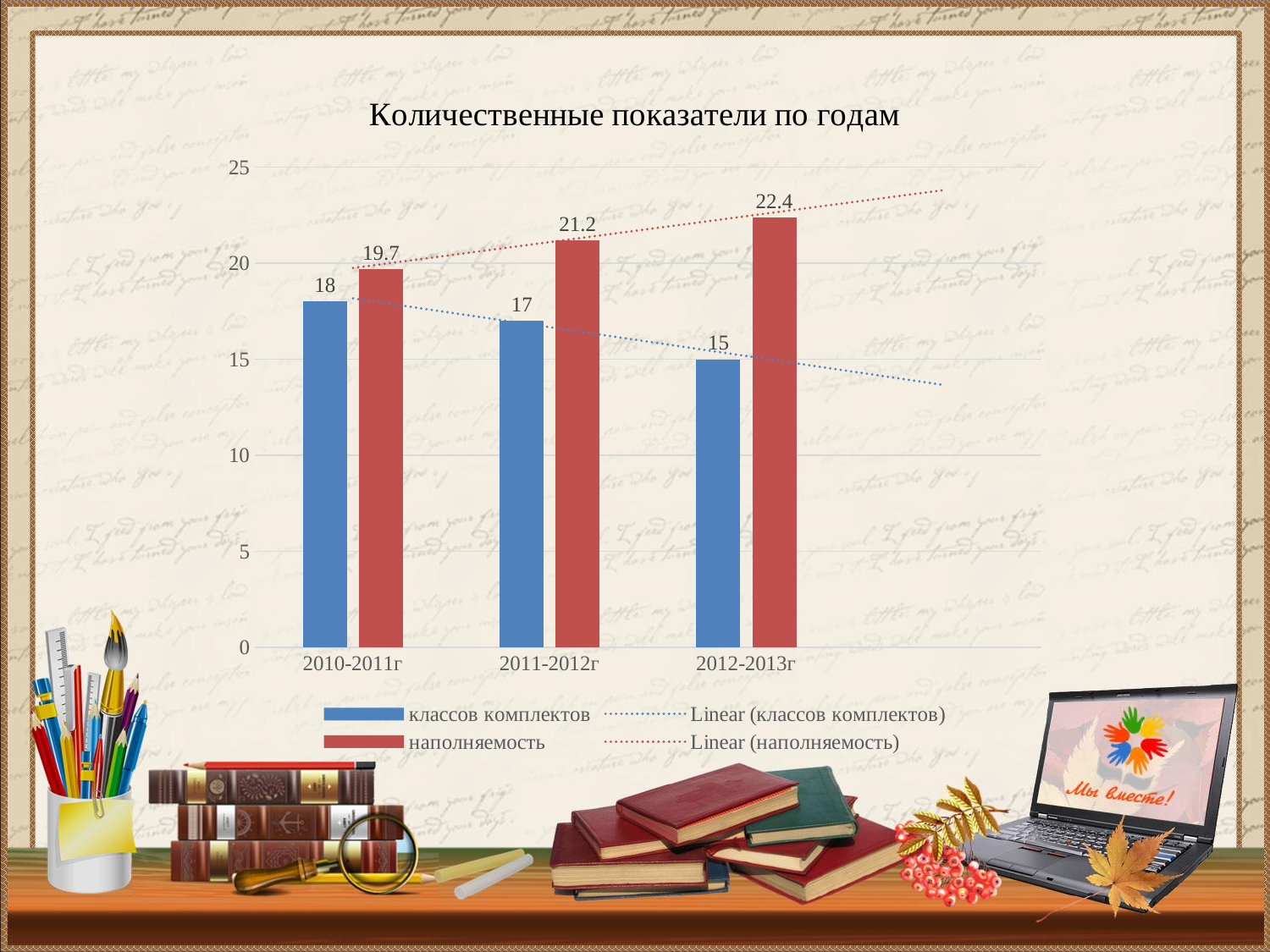
What kind of chart is shown on the slide? bar chart What is the value of наполняемость for 2012-2013г? 22.4 How many year categories are shown on the x axis? 3 Is the value of наполняемость for 2010-2011г greater or less than 20? less In which year is классов комплектов lowest? 2012-2013г Does классов комплектов rise or fall from 2010-2011г to 2012-2013г? fall What is the difference between наполняемость and классов комплектов in 2012-2013г? 7.4 How many entries does the legend list? 4 What is the value of наполняемость for 2011-2012г? 21.2 What is the value of классов комплектов for 2010-2011г? 18 Which is larger in 2010-2011г: классов комплектов or наполняемость? наполняемость In which year is наполняемость highest? 2012-2013г